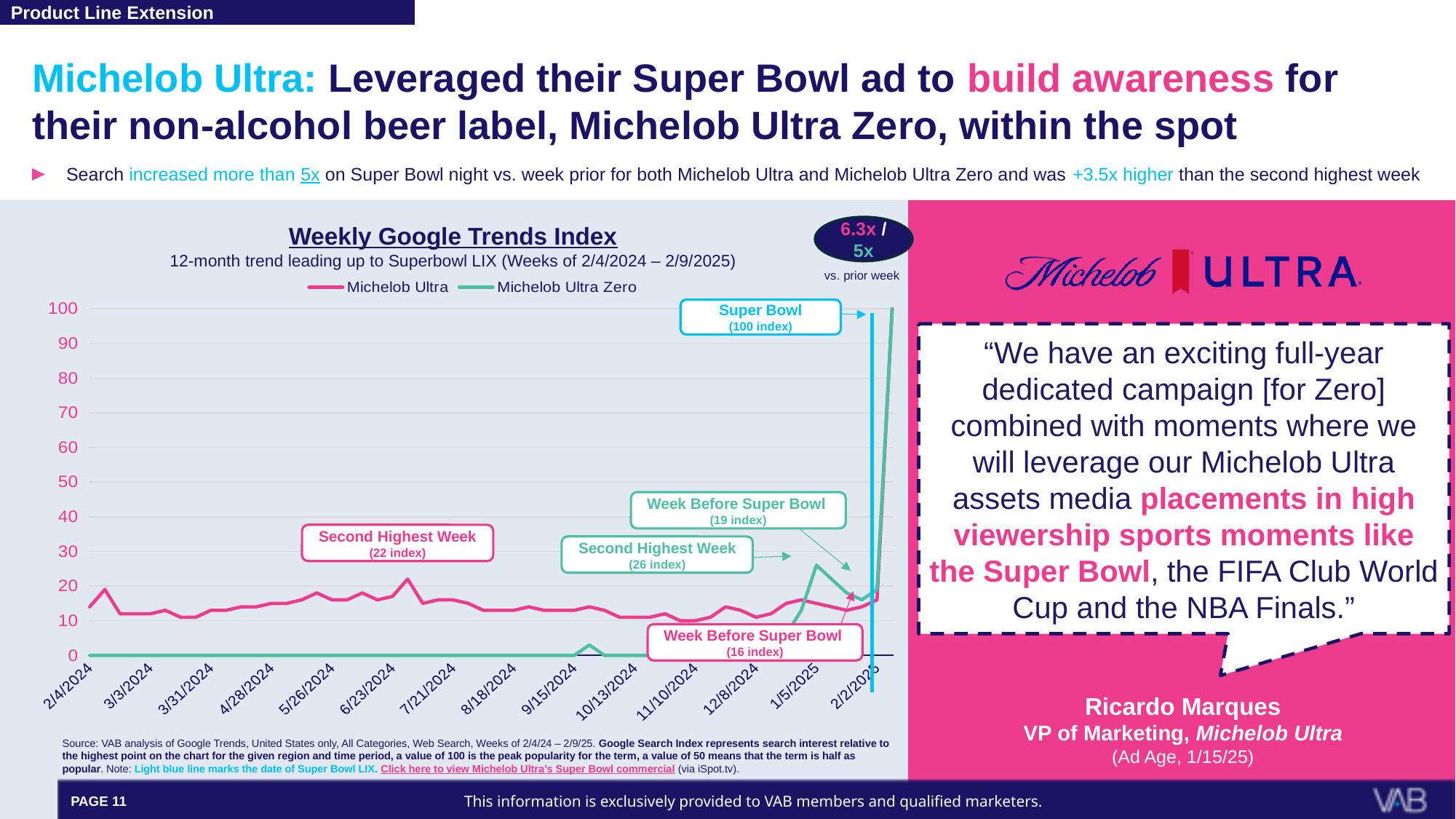
Which week has the highest value on the chart? Super Bowl week Is the Michelob Ultra value for the week of 2/4/2024 greater or less than 20? less What kind of chart is the Weekly Google Trends Index chart? Line chart What index value is labelled for Michelob Ultra Zero in the week before the Super Bowl? 19 index What index value is labelled for Michelob Ultra's second highest week? 22 index By how much does the Super Bowl week index (100) exceed Michelob Ultra's week-before-Super-Bowl index (16)? 84 What colour is the Michelob Ultra Zero line in the chart legend? Green What index value is labelled for the Super Bowl week on the chart? 100 index Which series has the higher labelled second highest week index, Michelob Ultra or Michelob Ultra Zero? Michelob Ultra Zero What index value is labelled for Michelob Ultra in the week before the Super Bowl? 16 index What index value is labelled for Michelob Ultra Zero's second highest week? 26 index How many series does the legend of the Weekly Google Trends Index chart list? 2